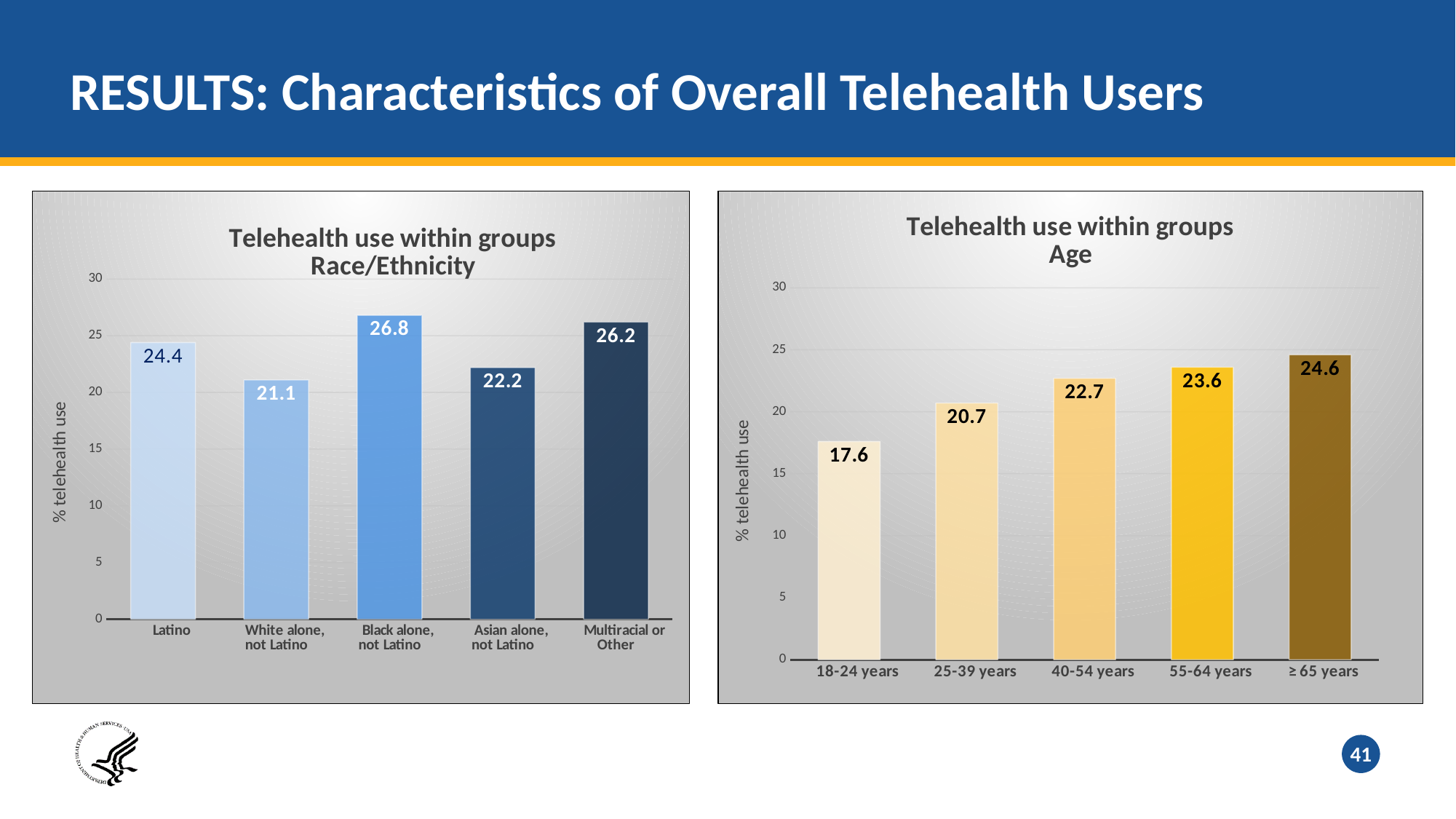
In the Race/Ethnicity chart, what is the % telehealth use for Latino? 24.4 In the Age chart, what is the % telehealth use for 25-39 years? 20.7 In the Race/Ethnicity chart, how many race/ethnicity groups are shown? 5 In the Race/Ethnicity chart, which group has the lowest % telehealth use? White alone, not Latino In the Age chart, which age group has the highest % telehealth use? ≥ 65 years In the Age chart, which age group has the lowest % telehealth use? 18-24 years In the Age chart, do the values rise or fall as age increases along the x axis? rise In the Race/Ethnicity chart, what is the difference between the values for Black alone, not Latino and Asian alone, not Latino? 4.6 In the Age chart, what is the difference between the values for ≥ 65 years and 18-24 years? 7.0 Which is larger: the value for Latino in the Race/Ethnicity chart or the value for 55-64 years in the Age chart? Latino In the Race/Ethnicity chart, which group has the highest % telehealth use? Black alone, not Latino What type of chart is the Age chart? bar chart